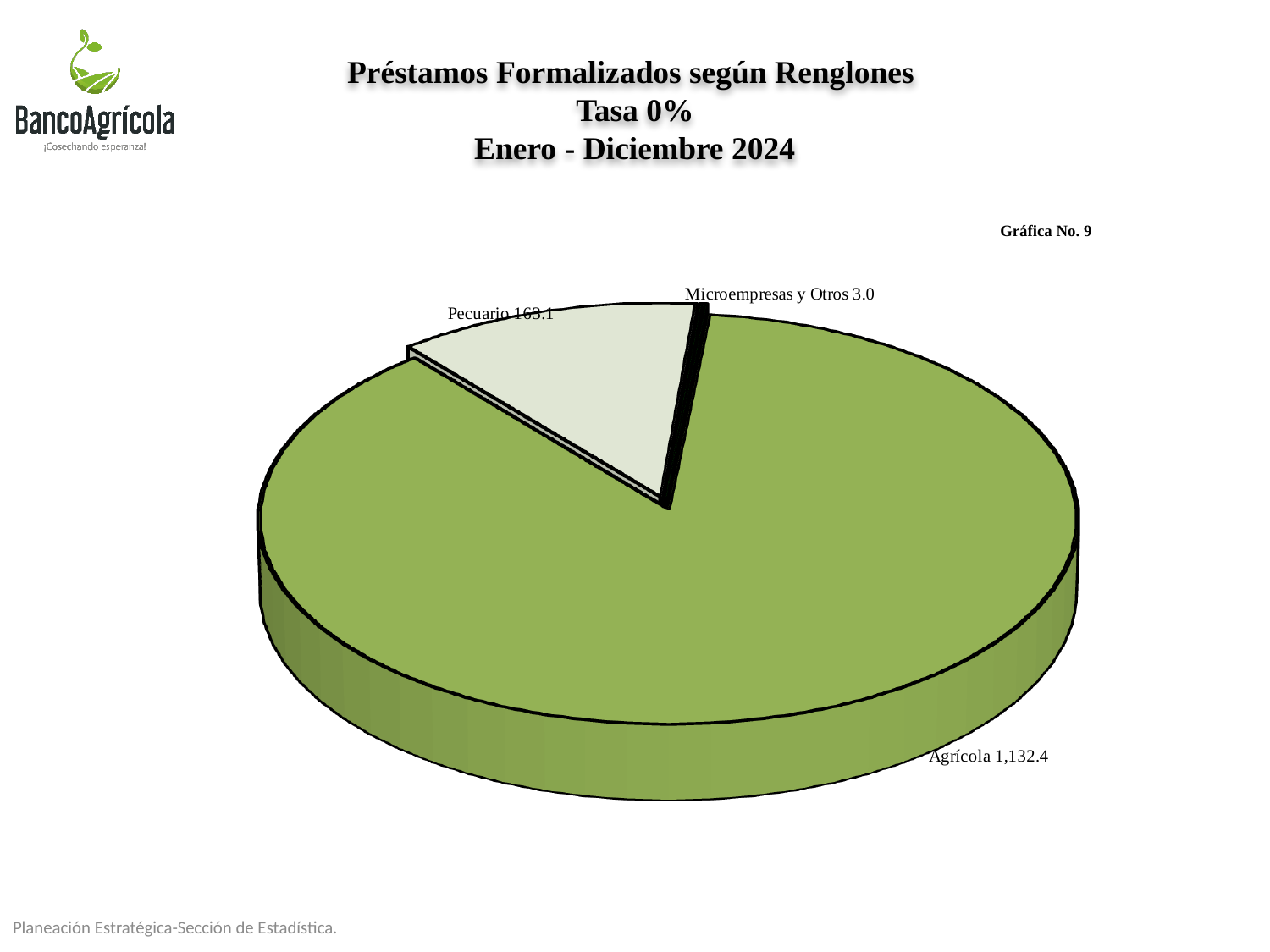
What is the total of all the slices in the pie chart? 1,298.5 What is the difference between the values for Agrícola and Pecuario? 969.3 Which is larger, the value for Pecuario or the value for Microempresas y Otros? Pecuario How many categories are shown in the pie chart? 3 What is the title of the chart? Préstamos Formalizados según Renglones Tasa 0% Enero - Diciembre 2024 Which category has the largest slice of the pie? Agrícola What is the difference between the values for Pecuario and Microempresas y Otros? 160.1 What kind of chart is shown on the slide? Pie chart Which category has the smallest slice of the pie? Microempresas y Otros What is the value for Microempresas y Otros? 3.0 What is the value for Pecuario? 163.1 What is the value for Agrícola? 1,132.4